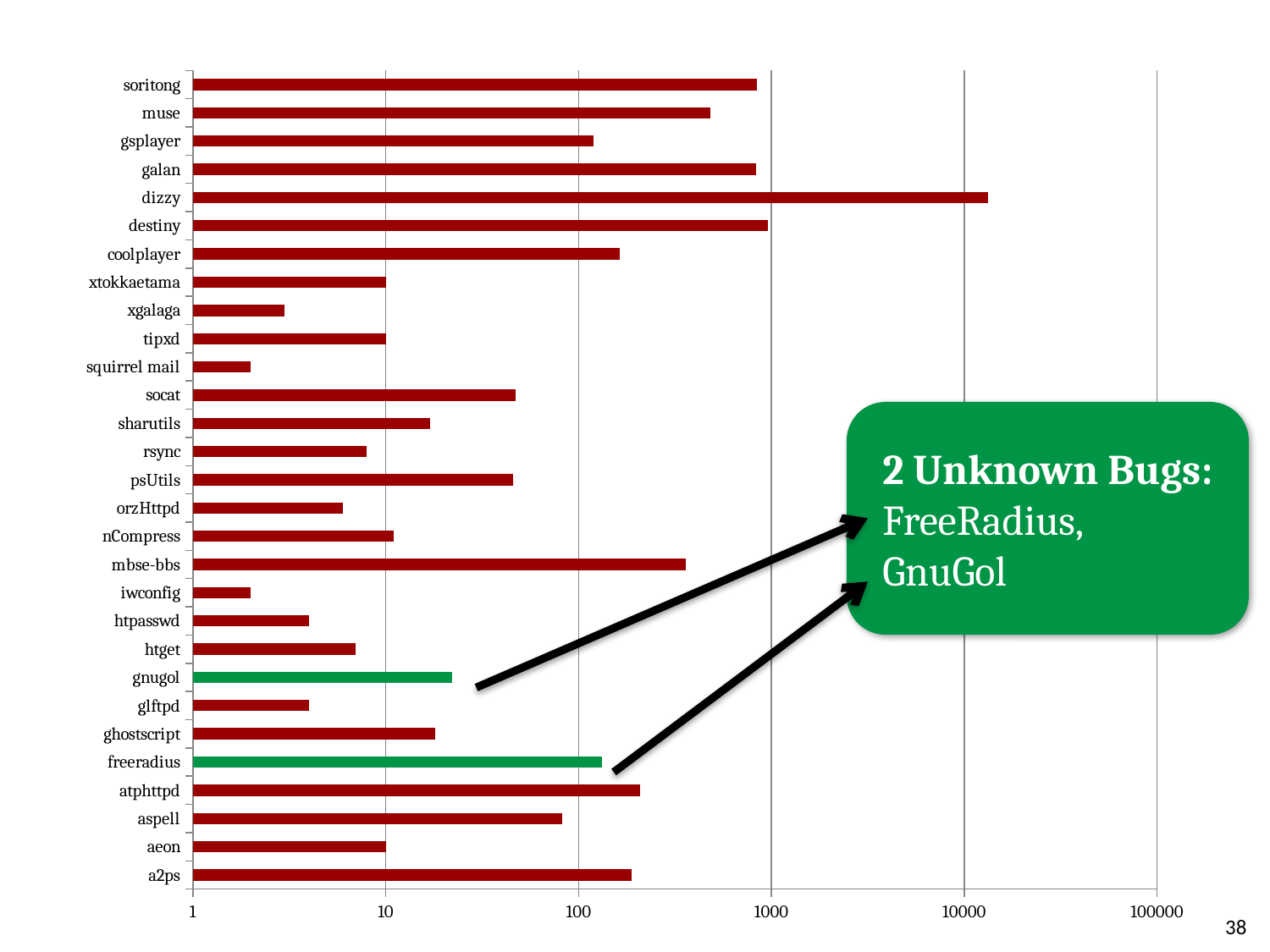
Which has the larger value, socat or rsync? socat Is the value for gnugol greater or less than 10? greater Which category has the highest value in the chart? dizzy Is the value for aspell greater or less than 100? less Is the value for soritong greater or less than 1000? less What kind of chart is shown on the slide? bar chart How many categories are plotted in the chart? 29 Which two categories are drawn with green bars instead of red? gnugol and freeradius Which has the larger value, mbse-bbs or gnugol? mbse-bbs